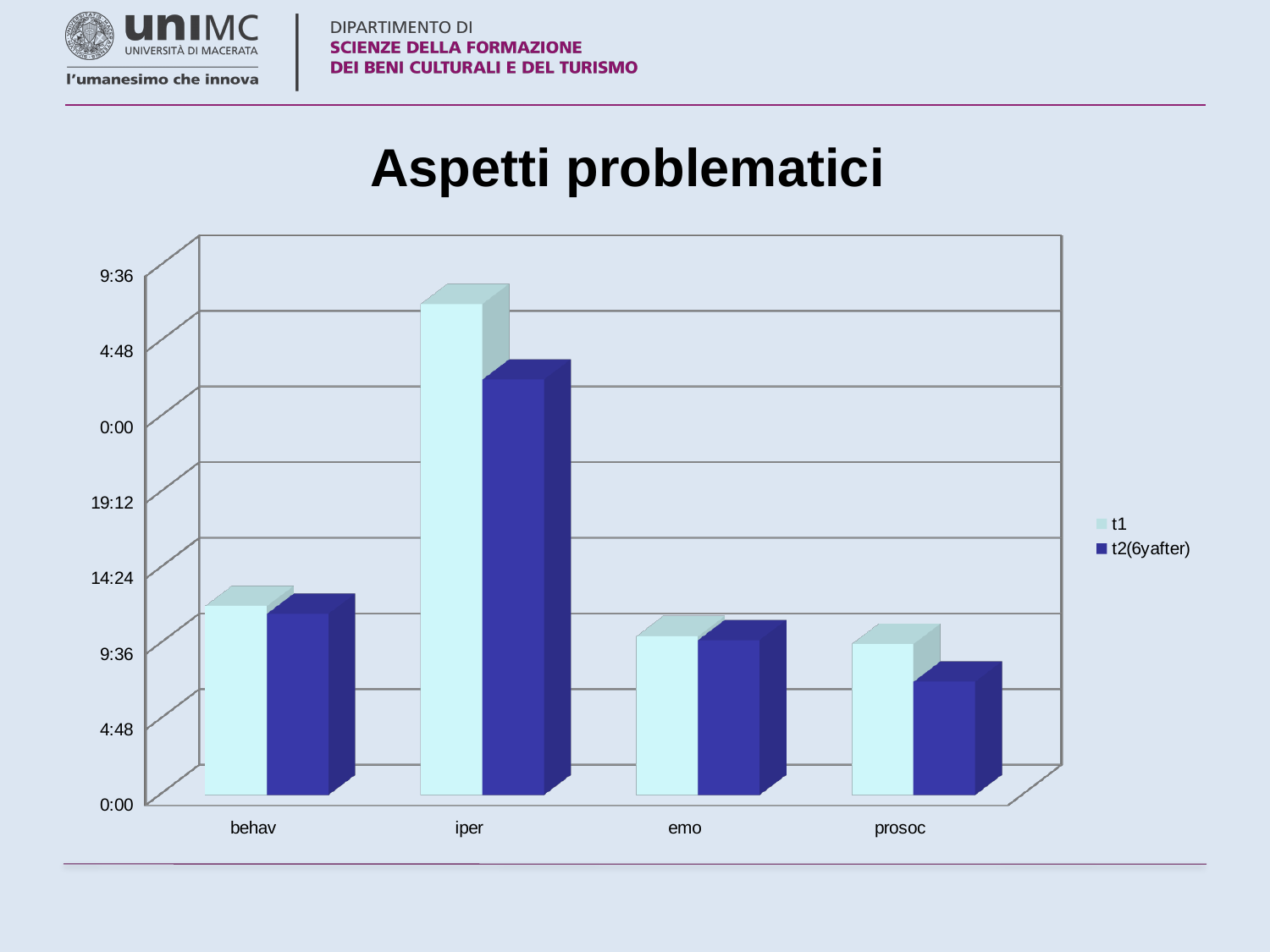
Which category has the lowest value for the t2(6yafter) series? prosoc What kind of chart is shown on the slide? bar chart For the category iper, which series has the larger value, t1 or t2(6yafter)? t1 In the t1 series, which is larger, behav or iper? iper Which category has the highest value for the t2(6yafter) series? iper Which category has the highest value for the t1 series? iper For the category prosoc, which series has the larger value, t1 or t2(6yafter)? t1 What are the two series named in the legend? t1 and t2(6yafter) How many categories are shown on the x axis of the chart? 4 What is the title of the chart? Aspetti problematici How many series does the chart legend list? 2